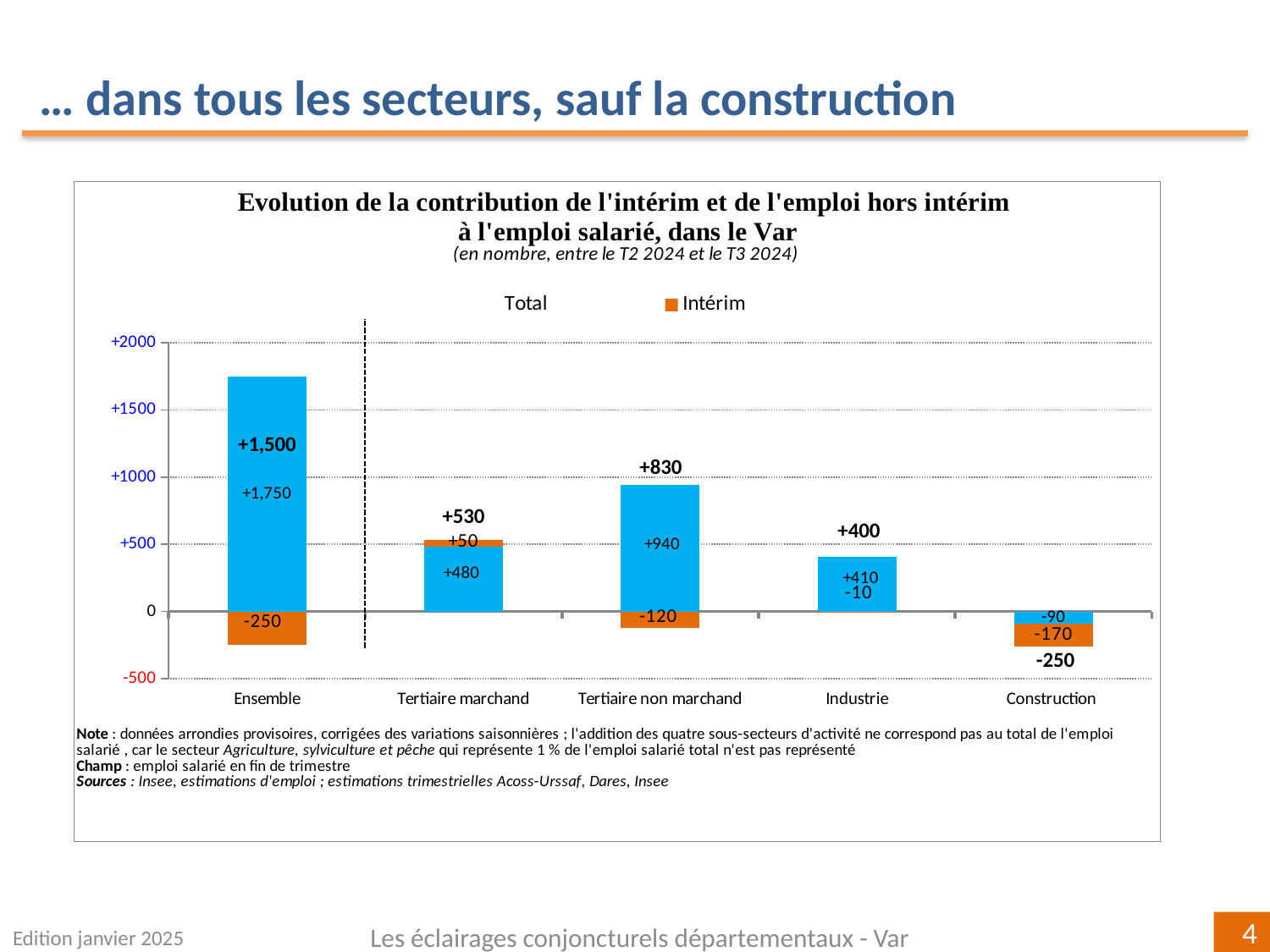
How many categories are shown on the x axis? 5 What is the Intérim value for Construction? -170 What is the Intérim value for Ensemble? -250 Which category has the lowest bold total value? Construction What is the bold total value shown for Tertiaire non marchand? +830 What value is printed inside the blue bar for Industrie? +410 How many entries does the legend list? 2 Is the blue bar for Tertiaire non marchand greater or less than +500? greater Which has the larger bold total value, Tertiaire marchand or Tertiaire non marchand? Tertiaire non marchand What kind of chart is shown on the slide? Bar chart Which category has the highest bold total value? Ensemble What is the difference between the bold total for Tertiaire marchand (+530) and the bold total for Industrie (+400)? 130